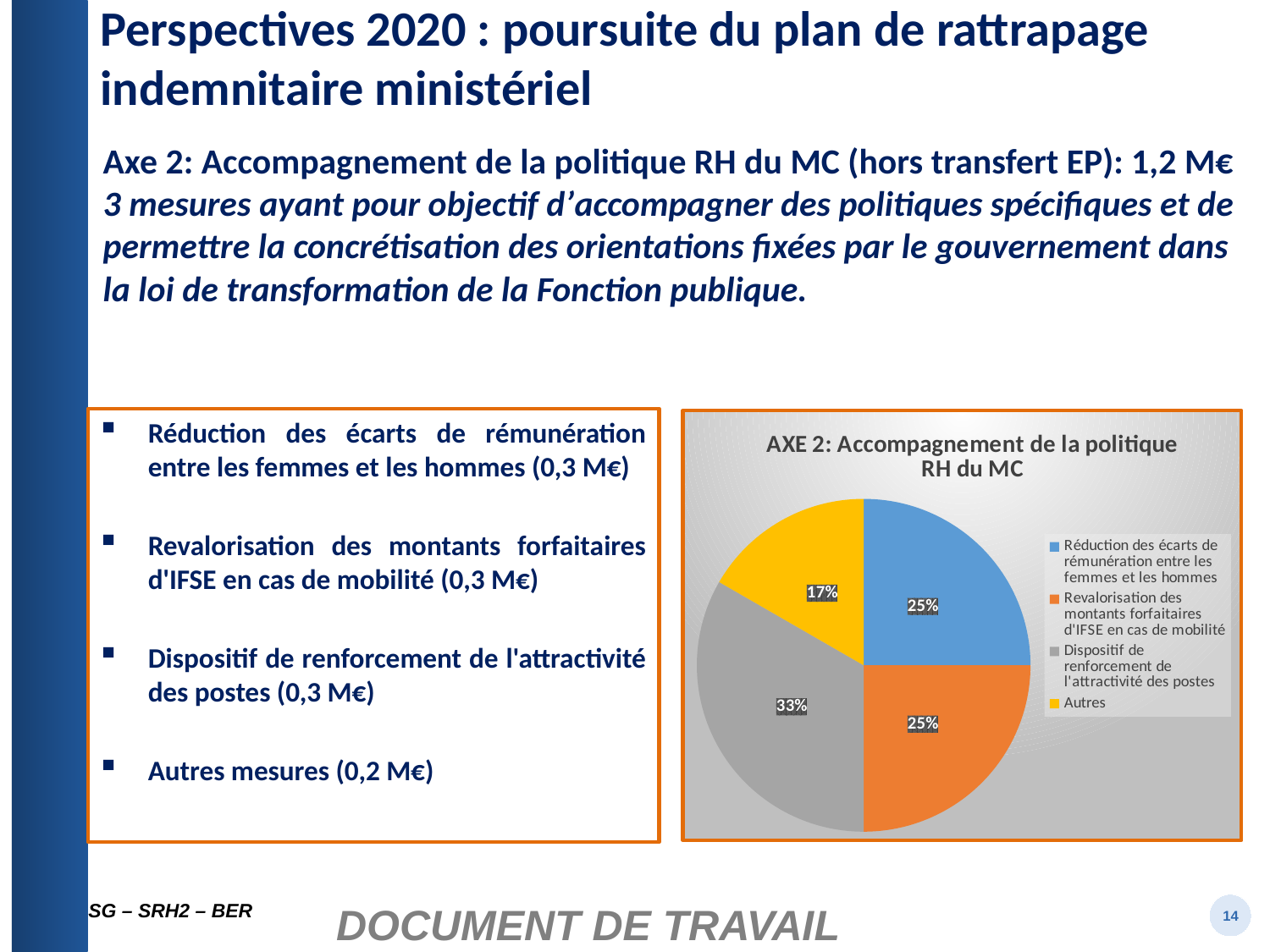
How many slices does the pie chart have? 4 What kind of chart is shown on the slide? pie chart What is the difference in percentage points between the 'Dispositif de renforcement de l'attractivité des postes' slice and the 'Autres' slice? 16 Which is larger: the 'Autres' slice or the 'Réduction des écarts de rémunération entre les femmes et les hommes' slice? Réduction des écarts de rémunération entre les femmes et les hommes What share of the pie is 'Réduction des écarts de rémunération entre les femmes et les hommes'? 25% What share of the pie is 'Autres'? 17% Which category has the largest slice of the pie? Dispositif de renforcement de l'attractivité des postes What is the title of the chart? AXE 2: Accompagnement de la politique RH du MC Which category has the smallest slice of the pie? Autres What share of the pie is 'Dispositif de renforcement de l'attractivité des postes'? 33% What colour is the 'Autres' slice in the pie chart? yellow